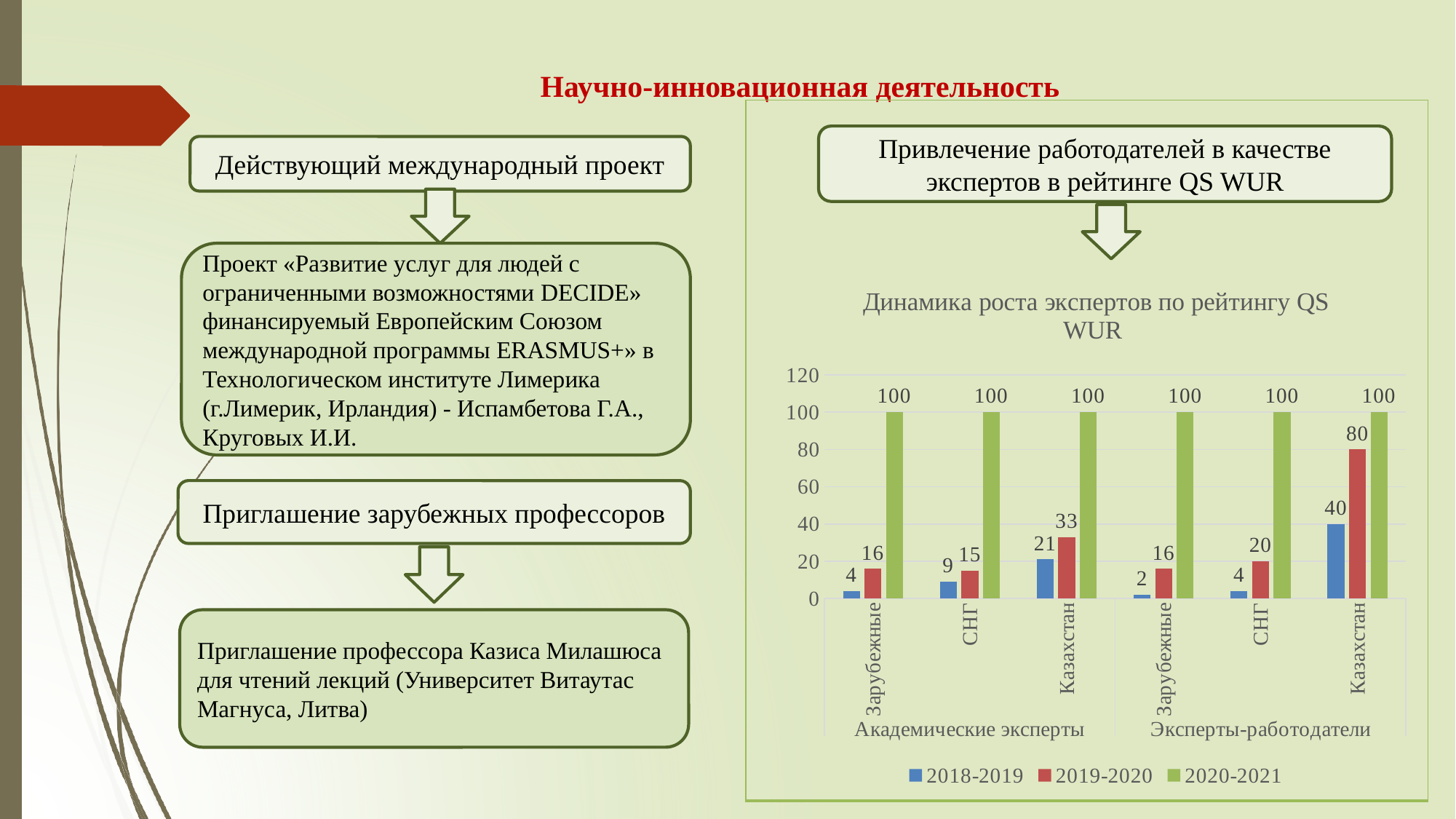
Which is larger: the 2019-2020 value for Казахстан among Академические эксперты or the 2019-2020 value for Казахстан among Эксперты-работодатели? Казахстан (Эксперты-работодатели) Which category has the lowest 2018-2019 value? Зарубежные (Эксперты-работодатели) How many series does the legend of the chart list? 3 What is the value for 2018-2019 for Зарубежные among Эксперты-работодатели? 2 What is the title of the chart? Динамика роста экспертов по рейтингу QS WUR What is the difference between the 2019-2020 and 2018-2019 values for Казахстан among Эксперты-работодатели? 40 What is the value for 2019-2020 for Казахстан among Академические эксперты? 33 What is the 2020-2021 value for every category in the chart? 100 What type of chart is shown on the slide? bar chart Which category has the highest 2018-2019 value? Казахстан (Эксперты-работодатели) What is the value for 2019-2020 for СНГ among Эксперты-работодатели? 20 What is the value for 2018-2019 for Казахстан among Эксперты-работодатели? 40